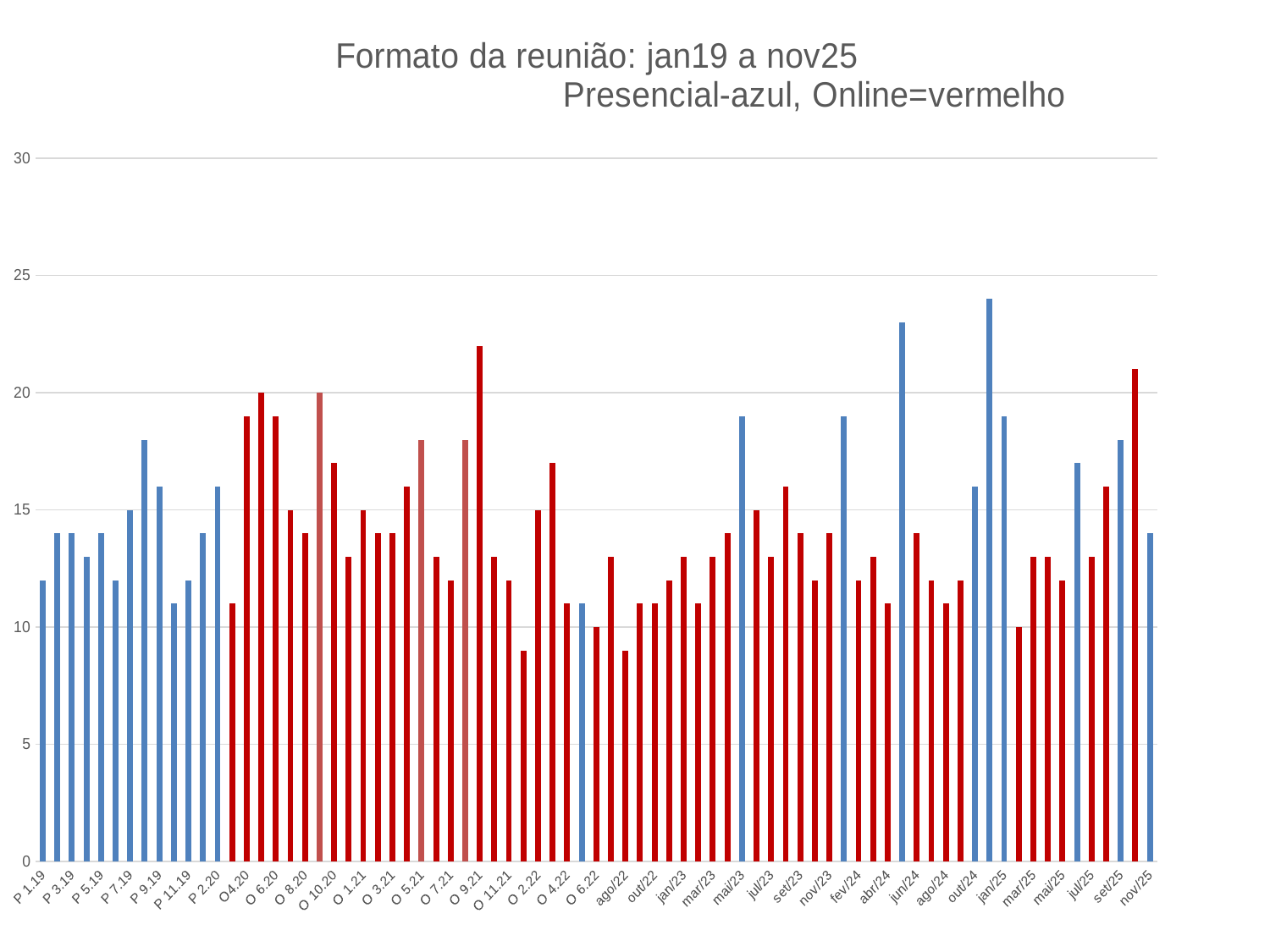
Is the value for O4.20 greater or less than 15? greater What is the maximum value shown on the vertical axis? 30 Is the lowest bar on the chart greater or less than 10? less What kind of chart is shown on the slide? bar chart Is the value for nov/25 greater or less than 15? less According to the chart subtitle, which colour represents Online meetings? vermelho (red) What is the title of the chart? Formato da reunião: jan19 a nov25 Presencial-azul, Online=vermelho Which is larger, the value for O 9.21 or the value for P 1.19? O 9.21